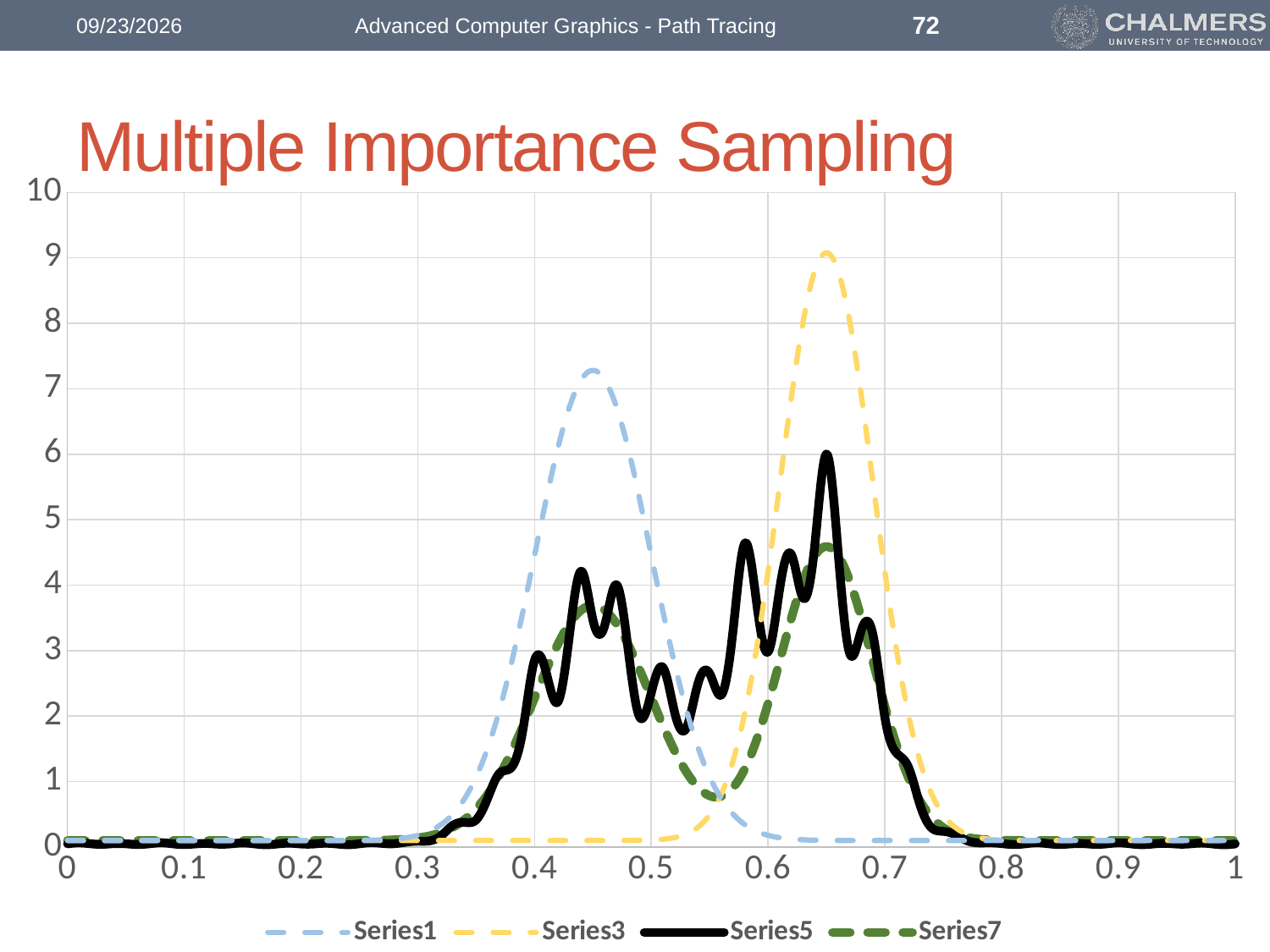
What kind of chart is shown on the slide? line chart Is the peak value of Series7 greater or less than 5? less What is the title of the chart? Multiple Importance Sampling Which has a higher peak, Series1 or Series3? Series3 Is the peak value of Series3 greater or less than 8? greater How many series does the legend list? 4 Which series reaches the highest value on the chart? Series3 Is the peak value of Series1 greater or less than 6? greater Which series has the lowest peak value? Series7 Which series is drawn as a solid black line? Series5